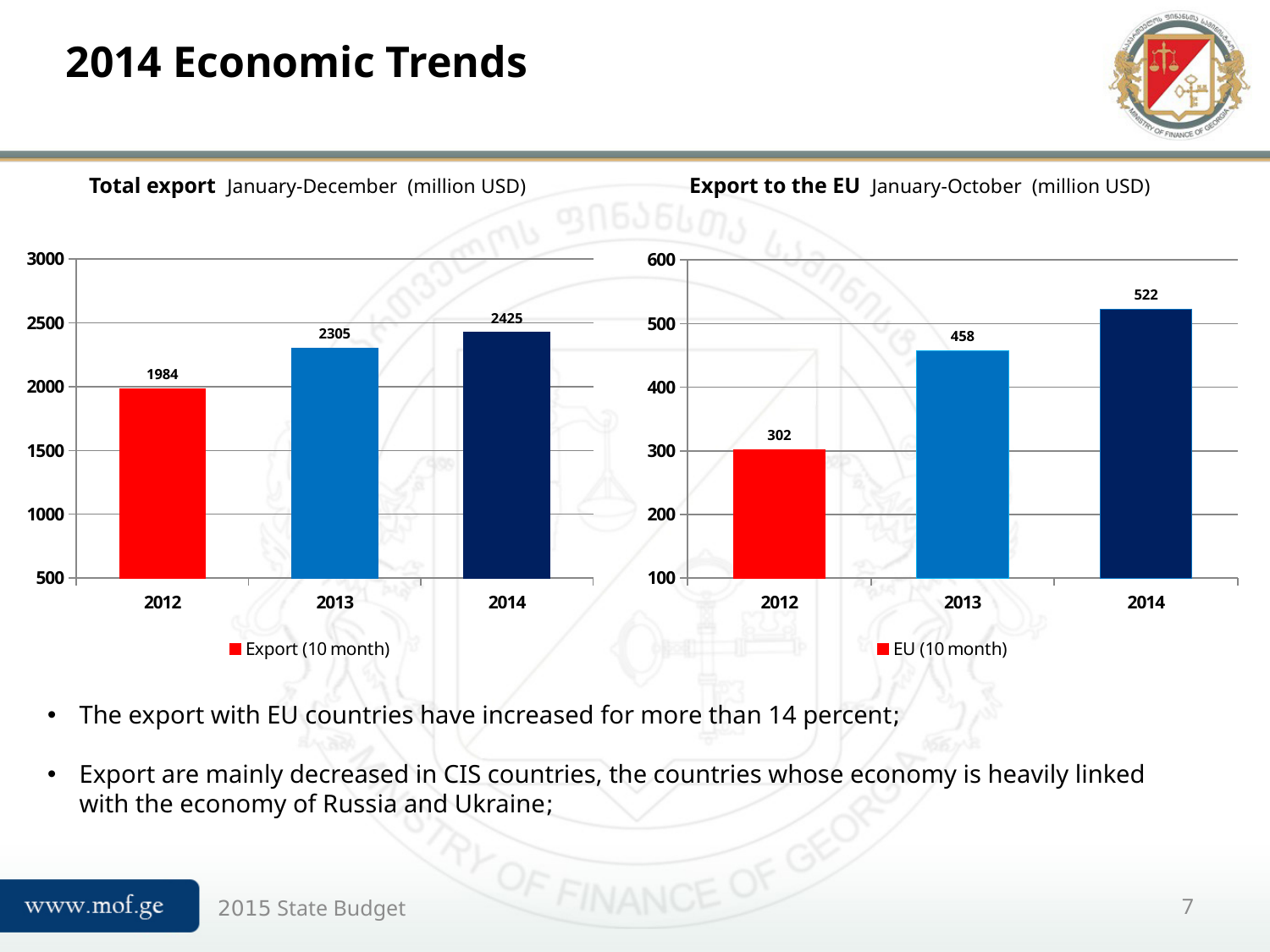
In the Export to the EU chart, which year has the lowest value? 2012 In the Export to the EU chart, is the value for 2012 larger or smaller than the value for 2014? smaller In the Total export chart, what is the value for 2012? 1984 What kind of chart is the Total export chart? bar chart In the Export to the EU chart, what is the value for 2013? 458 How many years are shown on the x axis of the Export to the EU chart? 3 In the Export to the EU chart, do the values rise or fall from 2012 to 2014? rise In the Total export chart, is the value for 2013 greater or less than 2000? greater In the Total export chart, what is the value for 2014? 2425 In the Export to the EU chart, what is the difference between the 2014 and 2013 values? 64 In the Total export chart, which year has the highest value? 2014 In the Total export chart, what is the difference between the 2013 and 2012 values? 321